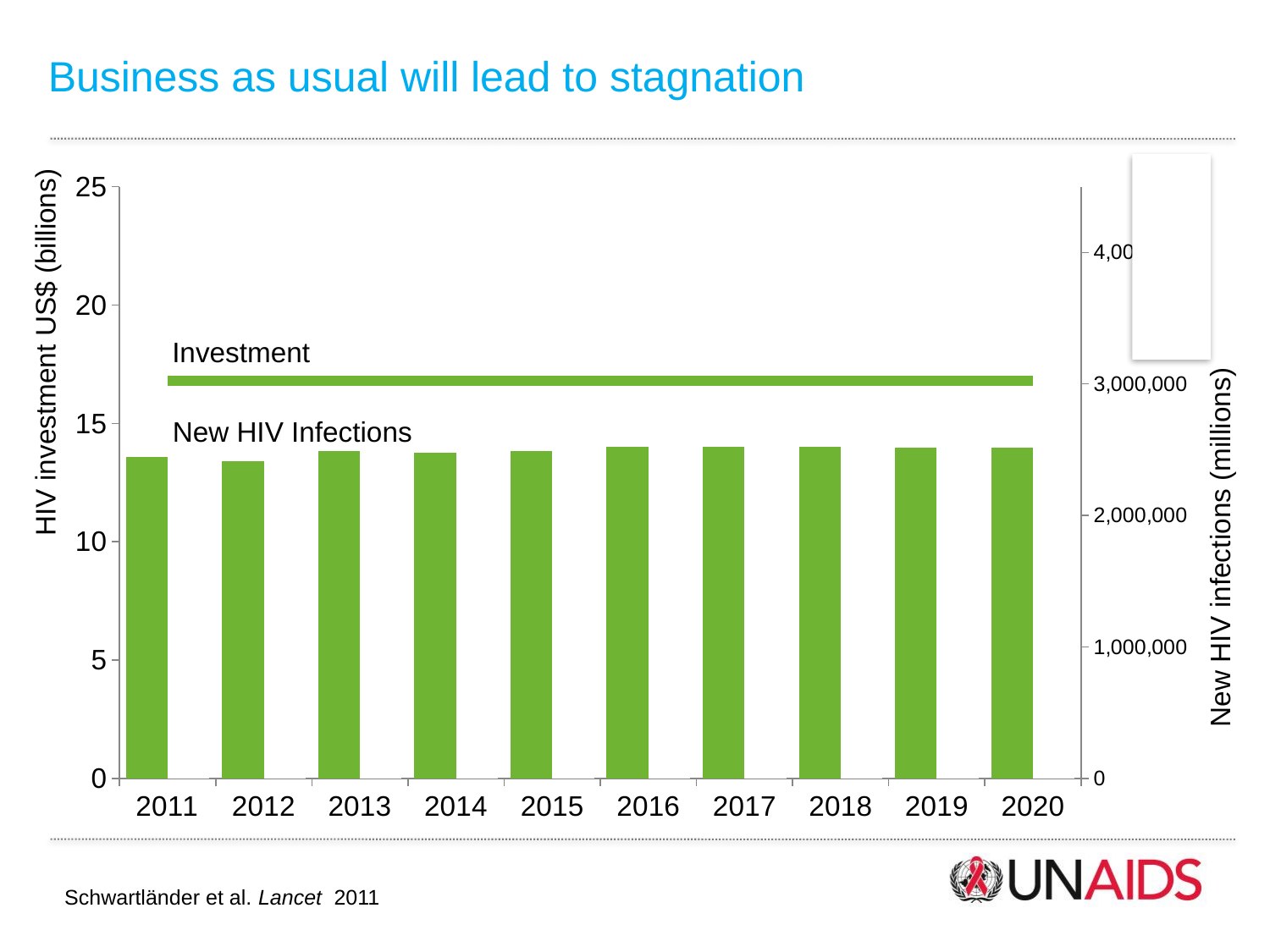
What kind of chart is shown on the slide? A bar chart with a line series What is the first year shown on the x axis? 2011 Does the Investment line rise, fall, or stay flat from 2011 to 2020? Stays flat How many years are shown along the x axis of the chart? 10 What is the last year shown on the x axis? 2020 Is the value for New HIV Infections in 2020 greater or less than 3,000,000? less Is the Investment value in 2015 greater or less than 15 (US$ billions)? greater What is the title of the chart on the slide? Business as usual will lead to stagnation Is the value for New HIV Infections in 2011 greater or less than 2,000,000? greater What is the label of the left vertical axis? HIV investment US$ (billions) Which series is plotted as bars: Investment or New HIV Infections? New HIV Infections